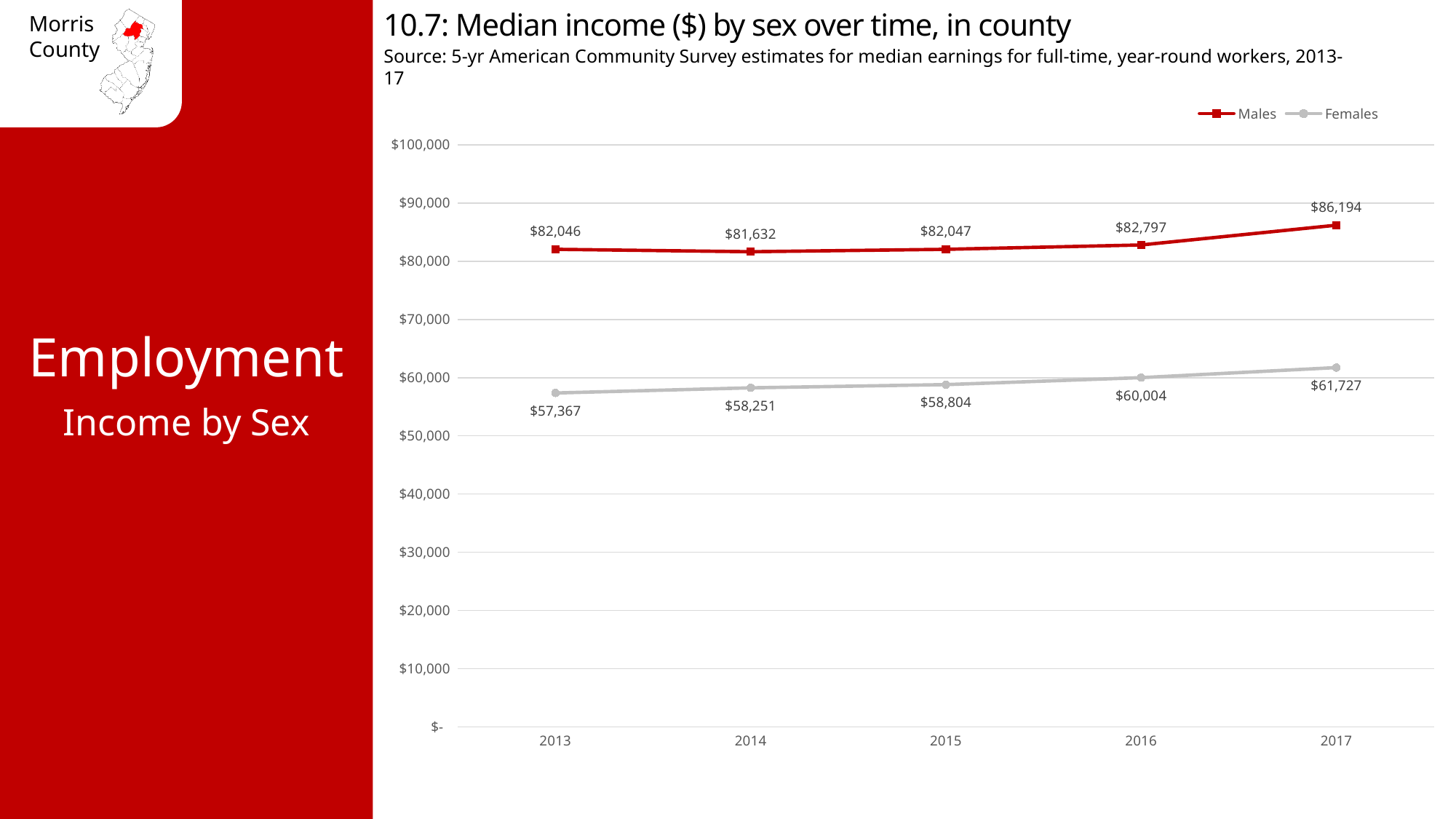
Which is larger in 2015, the Males median income or the Females median income? Males What is the difference between the Males and Females median income in 2017? $24,467 What kind of chart is shown on the slide? Line chart What is the median income for Females in 2016? $60,004 How many series does the legend list? 2 What is the median income for Males in 2017? $86,194 What is the median income for Females in 2013? $57,367 How many years are plotted on the x axis? 5 What is the median income for Males in 2014? $81,632 In which year is the Females median income lowest? 2013 Does the Females median income rise or fall from 2013 to 2017? Rise In which year is the Males median income highest? 2017